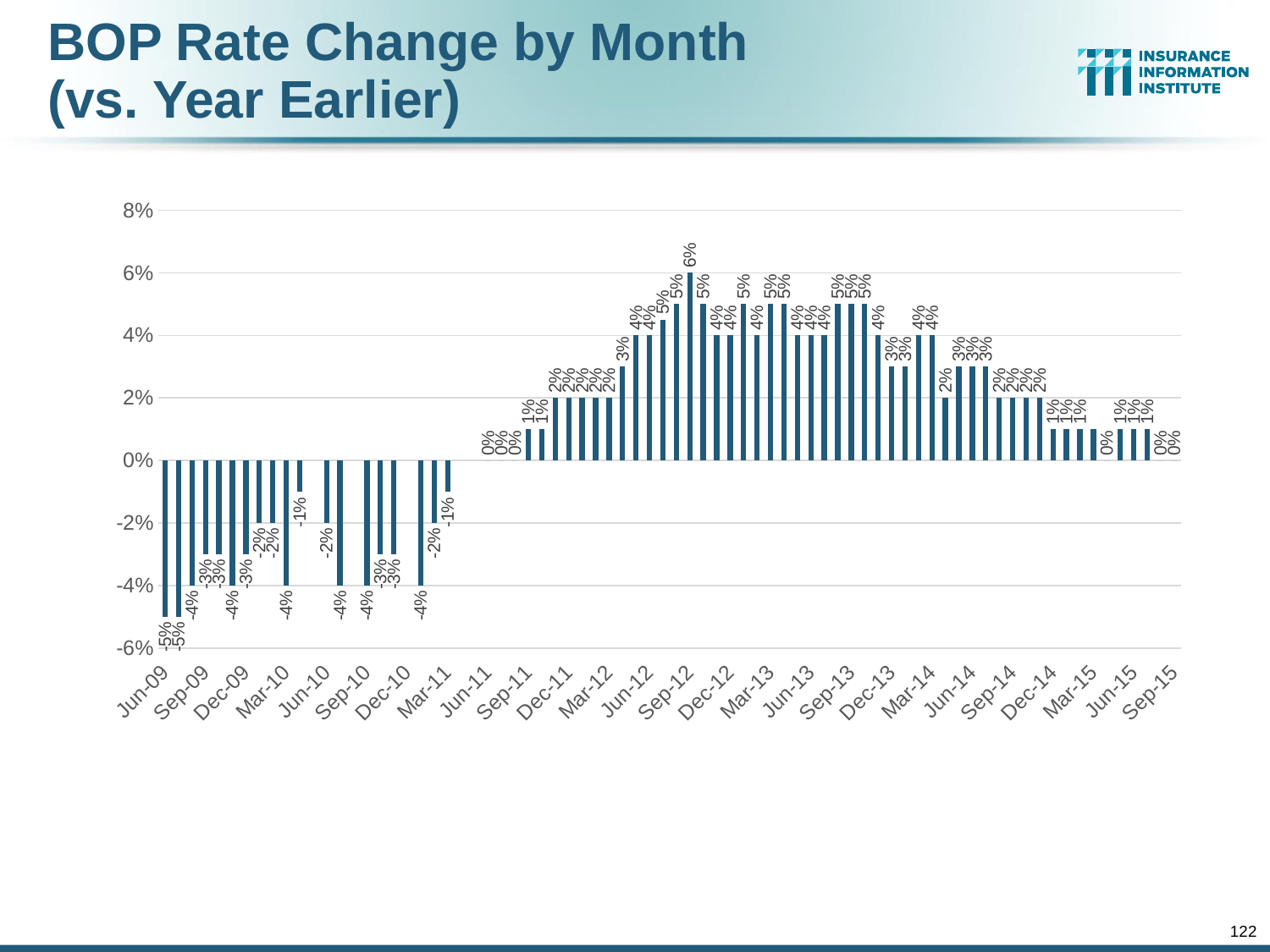
What kind of chart is shown on the slide? bar chart What is the highest rate change value shown in the chart? 6% Do the rate changes generally rise or fall from the 2012 peak to Sep-15? fall Do the rate changes generally rise or fall from Jun-09 to the peak in 2012? rise Which has the larger rate change, Jun-09 or Sep-15? Sep-15 What is the title of the chart? BOP Rate Change by Month (vs. Year Earlier) What is the difference between the highest and lowest rate change values on the chart? 11 percentage points What is the rate change for Jun-09, the first month on the chart? -5% What is the highest value shown on the vertical axis? 8% What is the rate change for Sep-15, the last month on the chart? 0% What is the lowest rate change value shown in the chart? -5% Is the value for Jun-09 greater or less than 0%? less